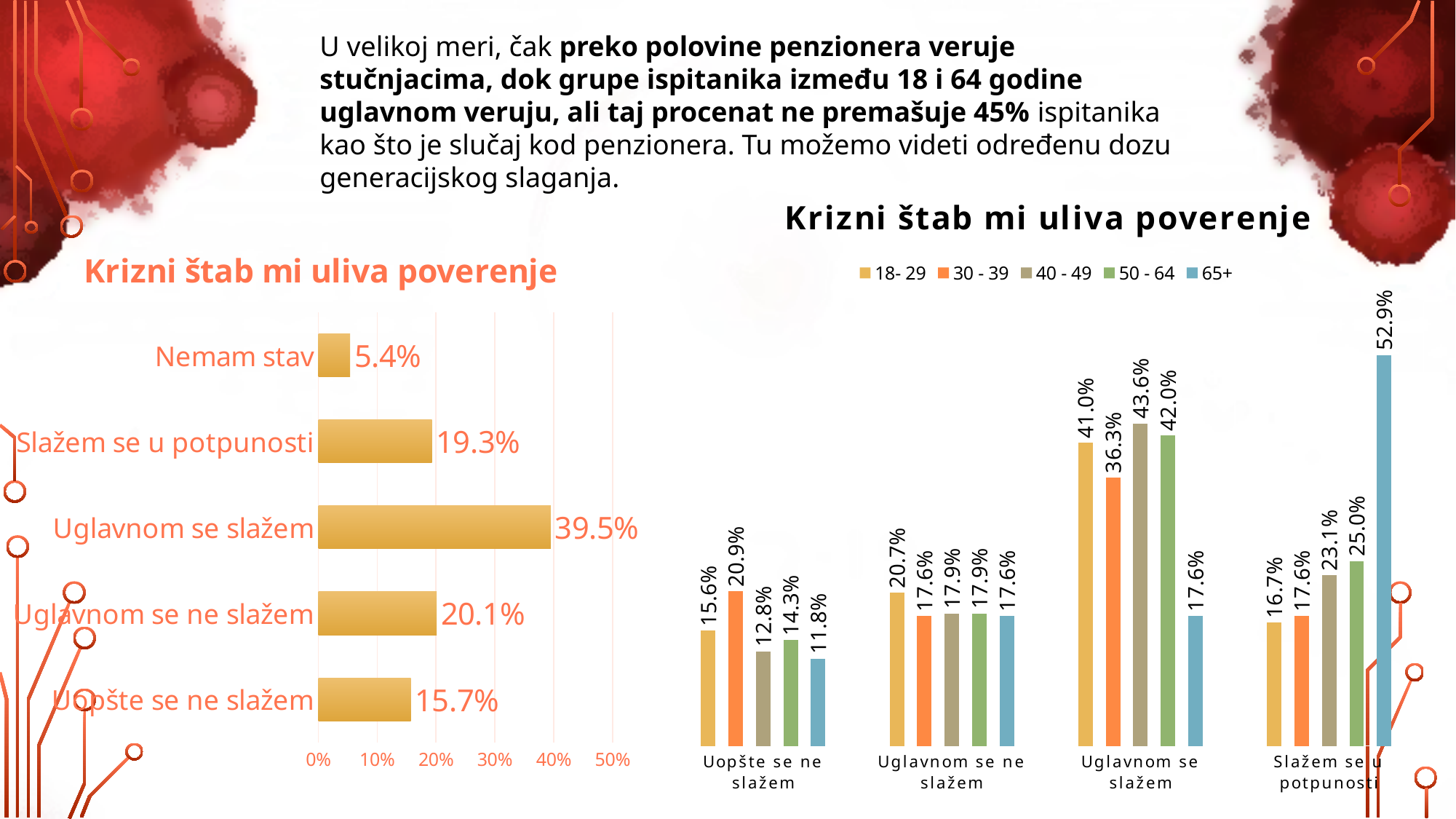
On the right chart, which age group has the highest value under Uglavnom se slažem? 40 - 49 On the right chart, which is larger under Slažem se u potpunosti: the 40 - 49 group or the 50 - 64 group? 50 - 64 On the right chart, how many series does the legend list? 5 On the left chart, which category has the lowest value? Nemam stav On the right chart, what is the value for the 30 - 39 group under Uopšte se ne slažem? 20.9% On the left chart, what is the difference between Uglavnom se ne slažem and Slažem se u potpunosti? 0.8% On the left chart, how many categories are shown? 5 On the left chart, what kind of chart is it? Bar chart On the right chart, which colour represents the 65+ group in the legend? Blue On the right chart, what is the value for the 65+ group under Slažem se u potpunosti? 52.9% On the left chart, what is the value for Uglavnom se slažem? 39.5% On the right chart, what is the difference between the 18- 29 and 65+ values under Uglavnom se slažem? 23.4%